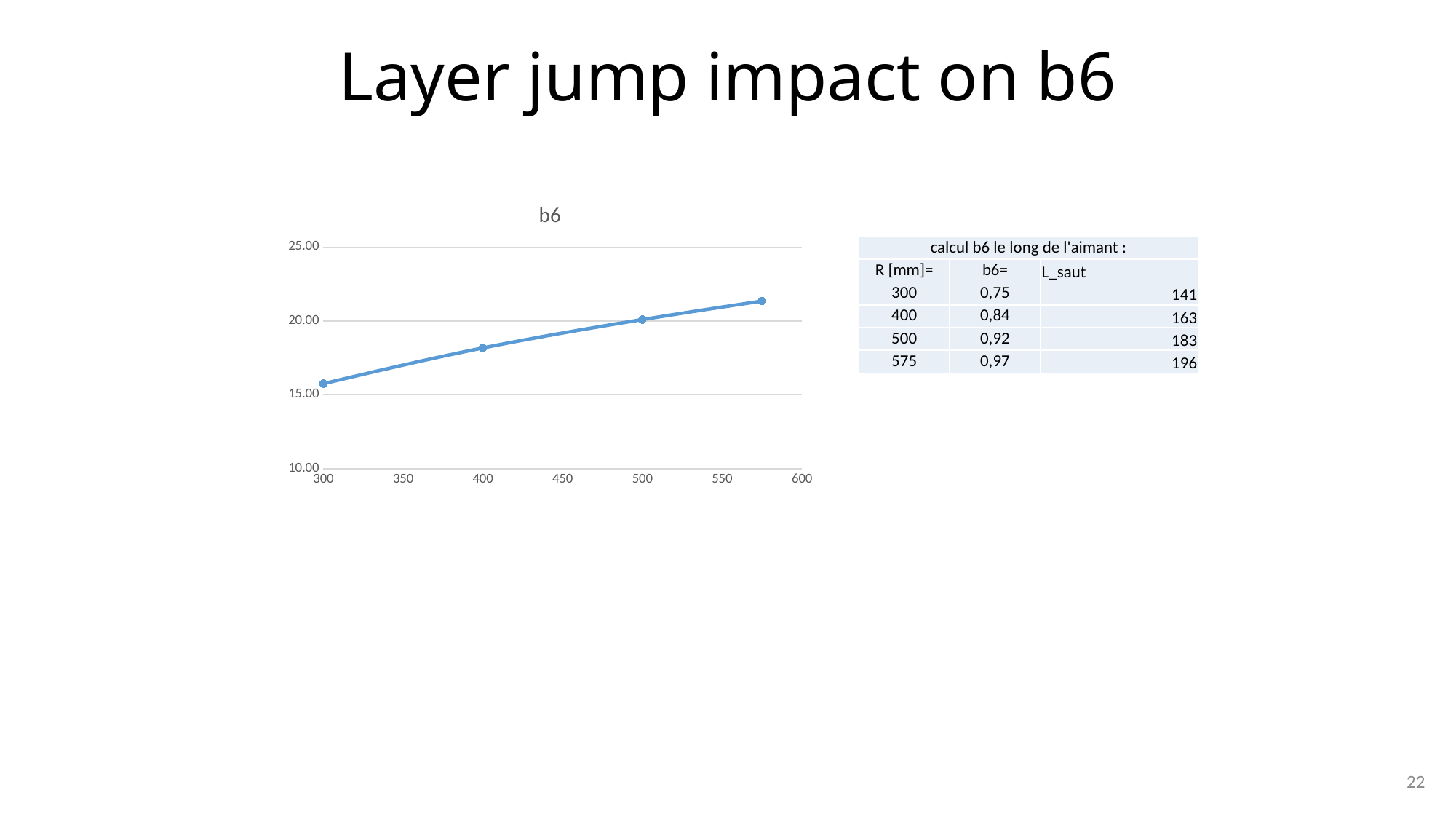
What is the title of the chart? b6 Which has the larger plotted value, x = 400 or x = 500? 500 What kind of chart is shown on the slide? line chart Do the plotted values rise or fall as the x-axis value increases from 300 to 575? rise Is the plotted value at x = 300 greater or less than 20.00? less How many data points are plotted on the line? 4 Is the plotted value at x = 575 greater or less than 20.00? greater Is the plotted value at x = 400 greater or less than 15.00? greater At which x value is the plotted value lowest? 300 At which x value is the plotted value highest? 575 What is the highest tick value shown on the y-axis of the chart? 25.00